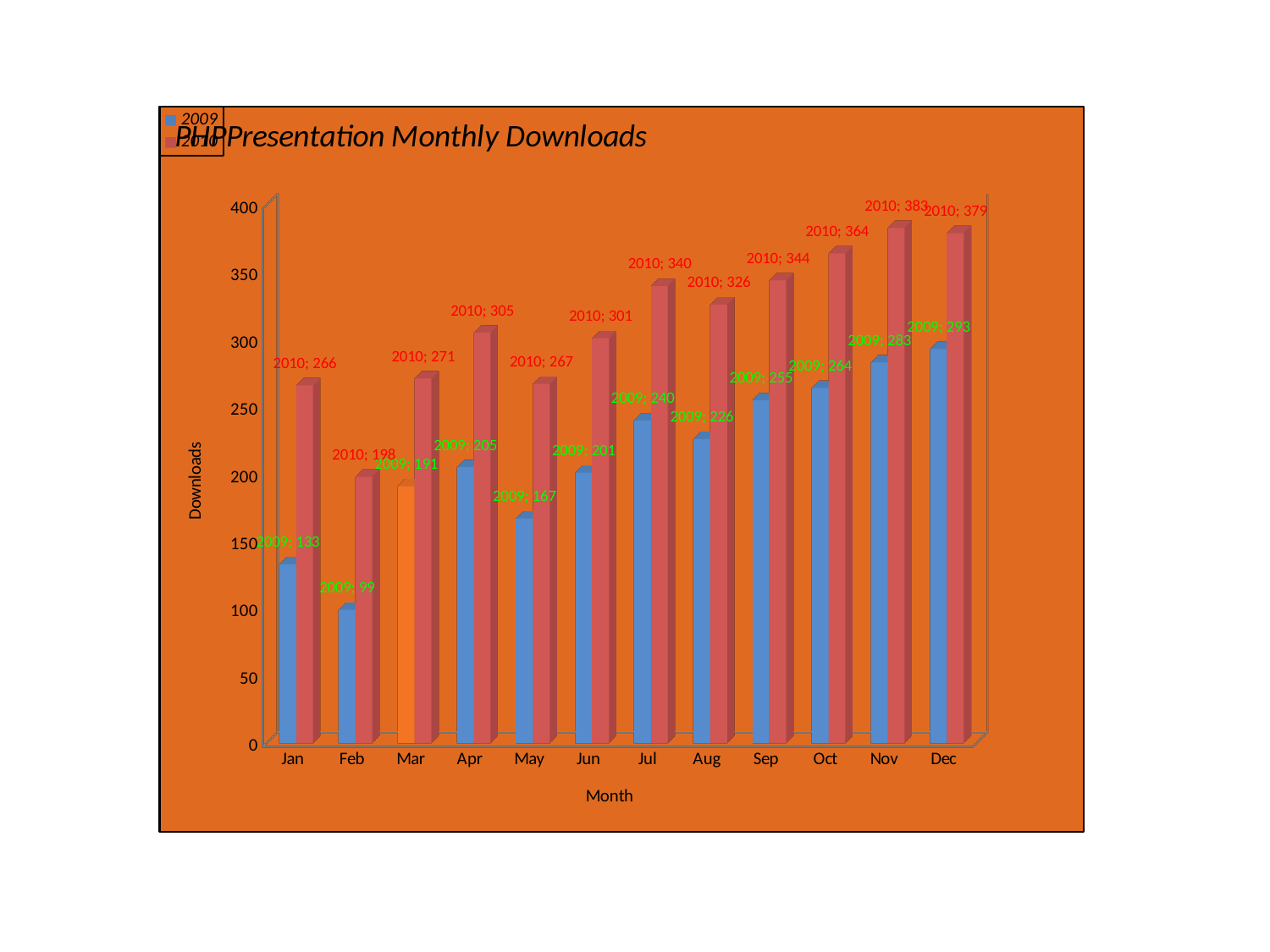
Which month has the highest 2010 value? Nov How many series does the legend list? 2 Which month has the lowest 2009 value? Feb What is the 2009 value for Sep? 255 What is the 2010 value for Jul? 340 What is the 2009 value for Feb? 99 What kind of chart is shown? Bar chart Which is larger, the 2010 value for Nov or the 2010 value for Dec? 2010 value for Nov Do the 2010 values generally rise or fall from Jan to Dec? Rise What is the difference between the 2010 and 2009 values for Jan? 133 What is the label of the y axis? Downloads How many months are shown on the x axis? 12